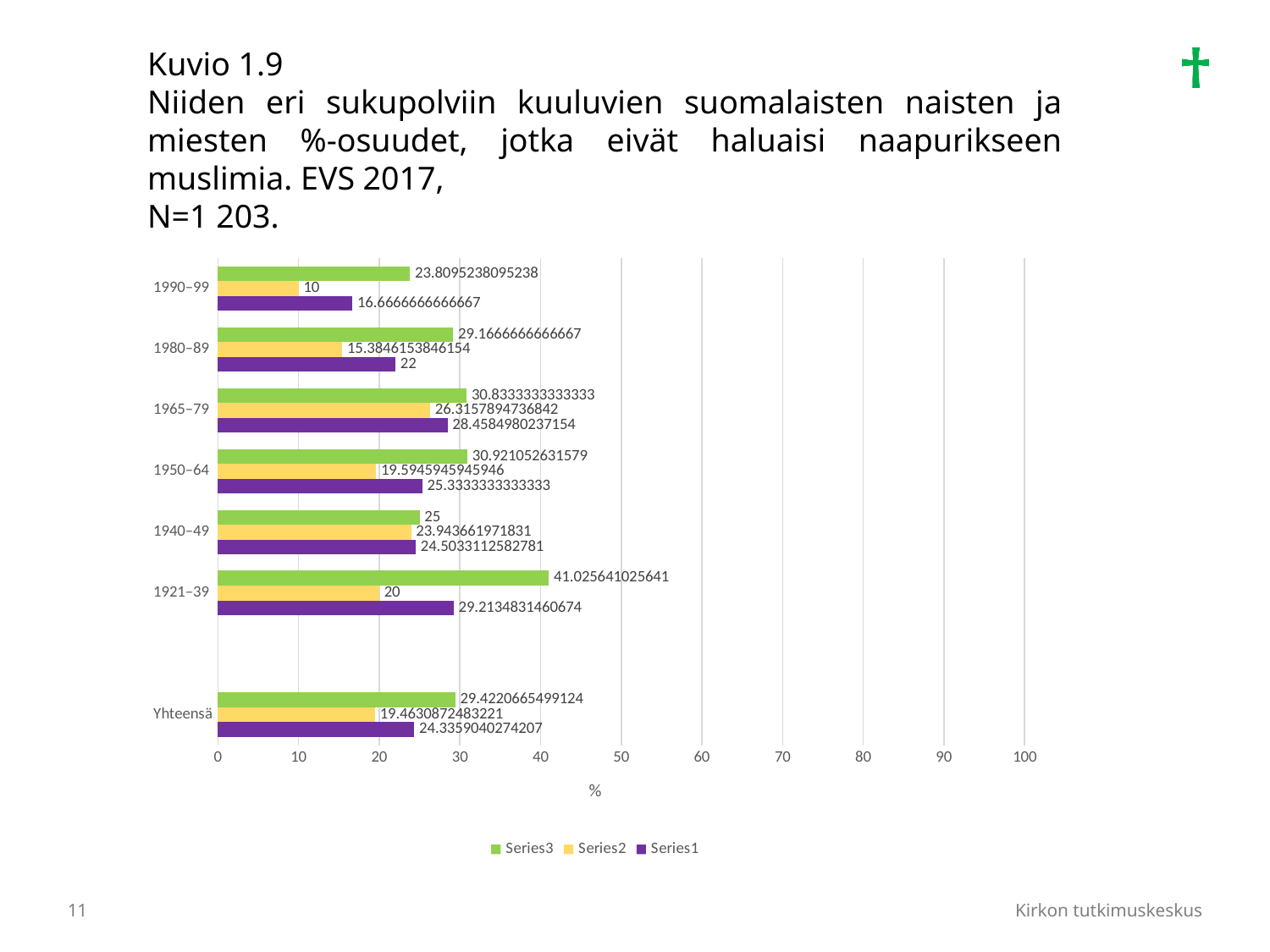
What is the difference between the Series2 value for 1921–39 and the Series2 value for 1990–99? 10 Is the Series3 value for 1921–39 greater or less than 40? greater How many categories are shown on the vertical axis of the chart? 7 Which is larger: the Series2 value for 1965–79 or the Series2 value for 1950–64? 1965–79 What is the value of Series1 for Yhteensä? 24.3359040274207 What kind of chart is shown on the slide? bar chart What is the value of Series2 for 1990–99? 10 Which category has the lowest Series2 value? 1990–99 How many series does the legend list? 3 What is the value of Series1 for 1980–89? 22 What is the value of Series3 for 1921–39? 41.025641025641 Which category has the highest Series3 value? 1921–39